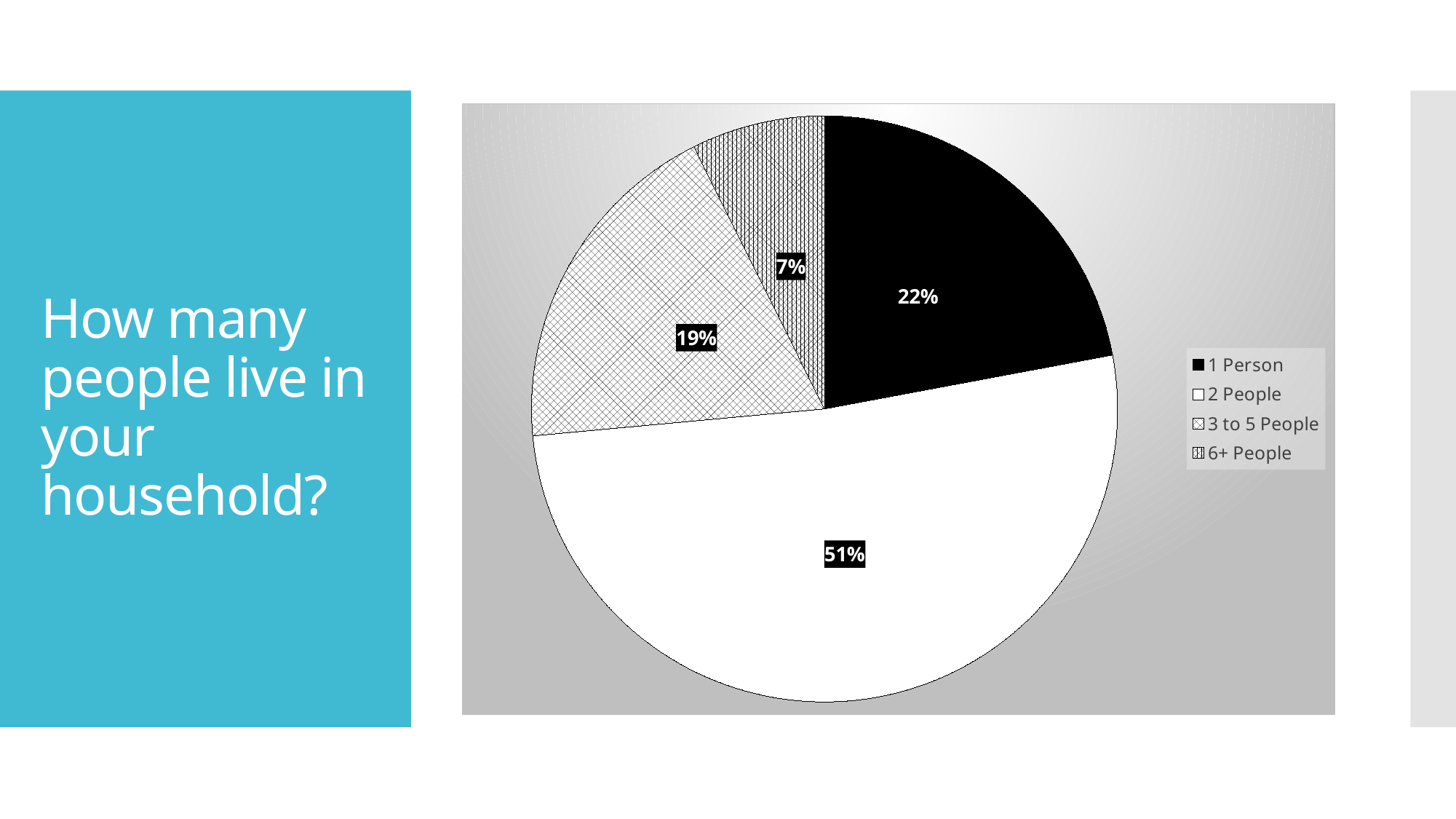
Which household size category has the smallest slice of the pie? 6+ People What is the difference in percentage points between the 3 to 5 People slice and the 6+ People slice? 12 What share of the pie is labelled for 6+ People? 7% What share of the pie is labelled for 2 People? 51% How many categories does the pie chart show? 4 What share of the pie is labelled for 1 Person? 22% What question does the slide title ask about the chart? How many people live in your household? What is the difference in percentage points between the 2 People slice and the 1 Person slice? 29 Which slice is larger, 1 Person or 3 to 5 People? 1 Person What kind of chart is shown on the slide? Pie chart Which household size category has the largest slice of the pie? 2 People